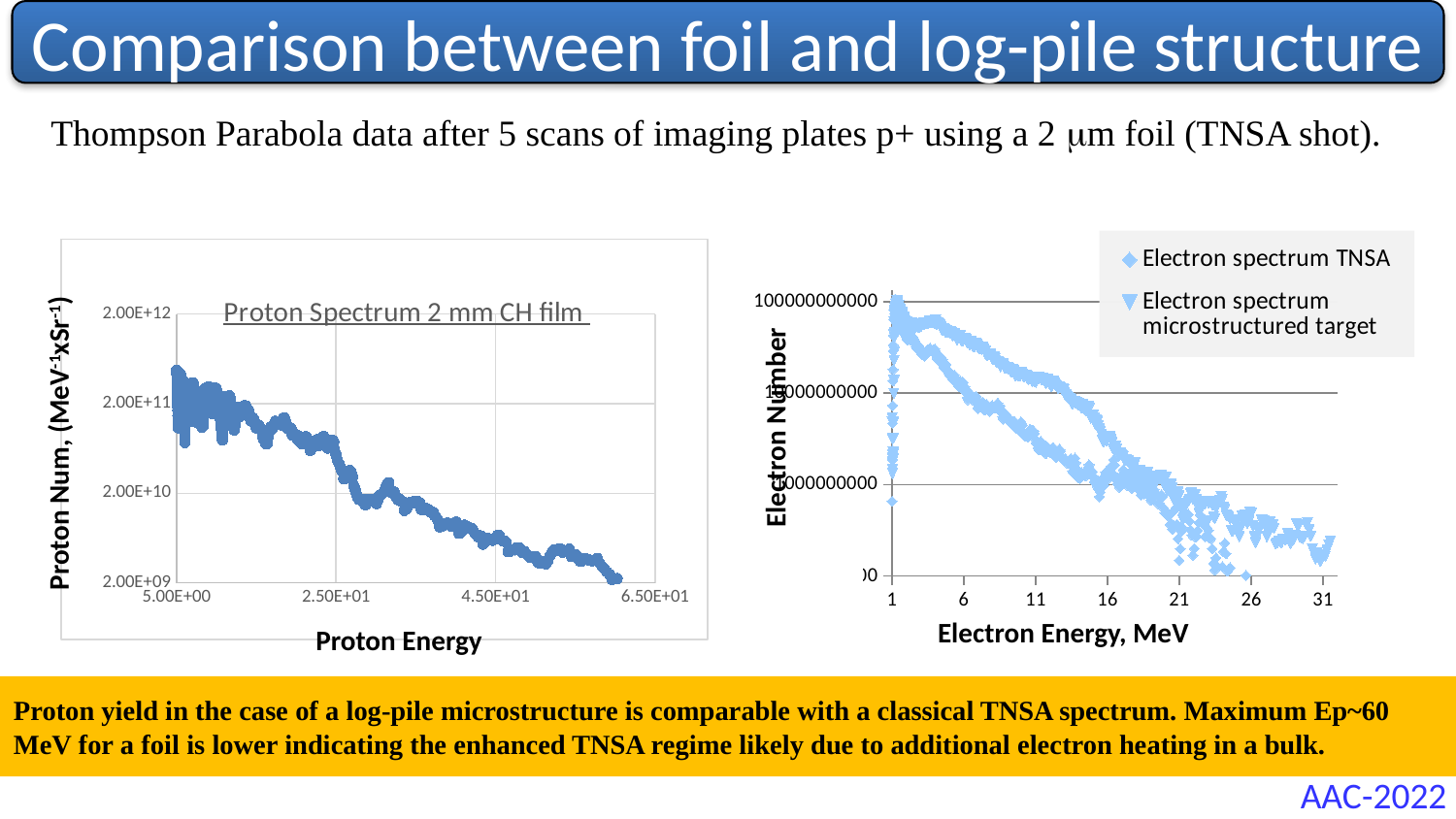
What is the title of the chart on the left? Proton Spectrum 2 mm CH film In the left chart, Proton Spectrum 2 mm CH film, is the value at a proton energy of 4.50E+01 greater or less than 2.00E+10? less What is the x-axis title of the left chart, Proton Spectrum 2 mm CH film? Proton Energy What kind of chart is the left chart, Proton Spectrum 2 mm CH film? scatter chart In the right chart, do the electron numbers rise or fall as electron energy increases? fall How many series does the legend of the right chart list? 2 What kind of chart is the right chart showing electron spectra? scatter chart In the right chart, are the values of both series at 21 MeV greater or less than 10000000000? less In the left chart, Proton Spectrum 2 mm CH film, do the values rise or fall as proton energy increases? fall What are the two series named in the legend of the right chart? Electron spectrum TNSA; Electron spectrum microstructured target